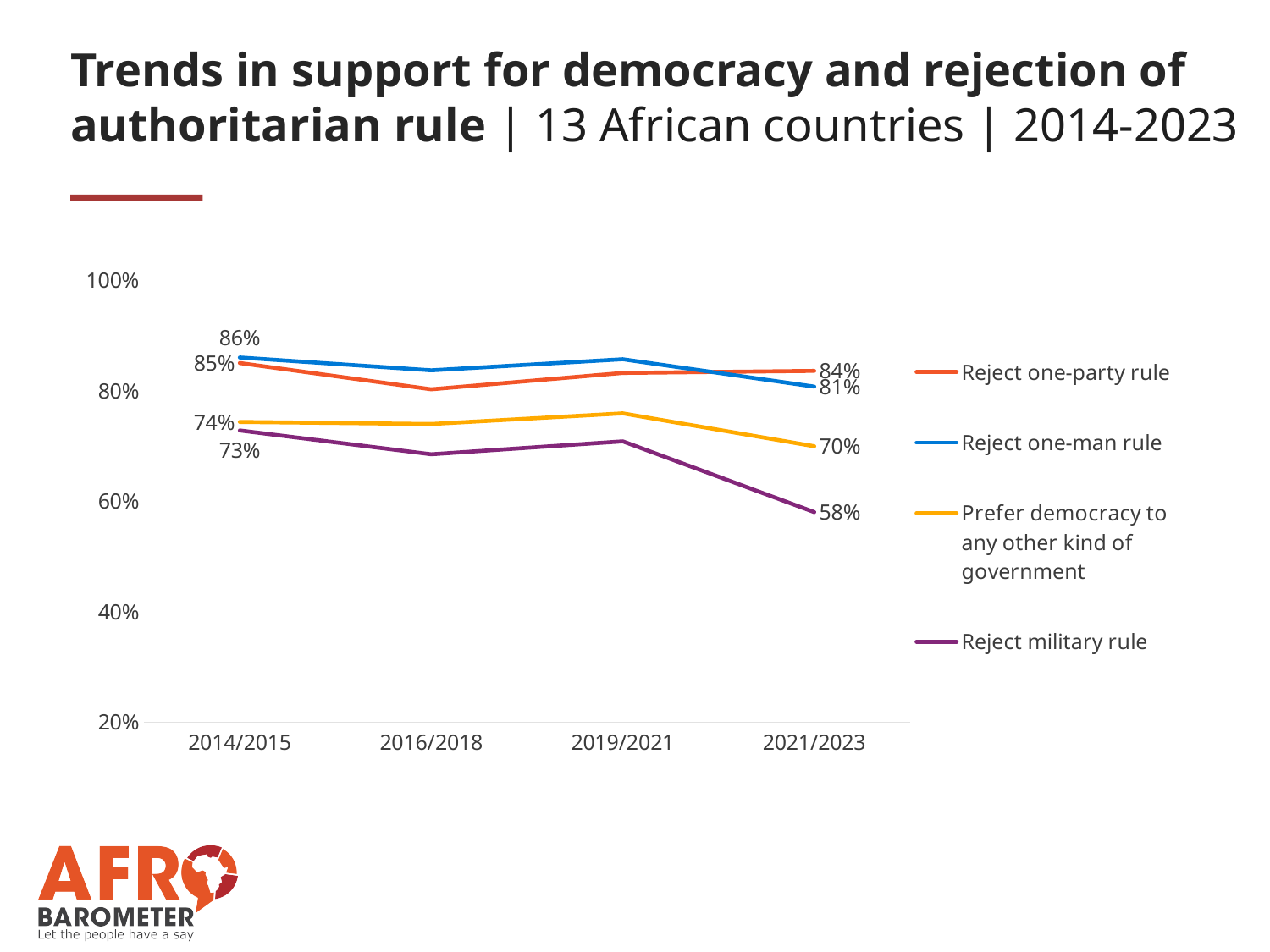
How many series does the legend list? 4 What is the value for Reject one-party rule in 2021/2023? 84% What is the value for Reject military rule in 2021/2023? 58% In 2021/2023, which is higher: Reject one-party rule or Reject one-man rule? Reject one-party rule What is the value for Prefer democracy to any other kind of government in 2014/2015? 74% What is the difference between Reject one-party rule and Reject one-man rule in 2021/2023? 3 percentage points What is the value for Reject one-man rule in 2014/2015? 86% By how many percentage points did Reject military rule change from 2014/2015 to 2021/2023? 15 percentage points Which series has the lowest value in 2021/2023? Reject military rule How many survey periods are shown on the x axis? 4 Is the value for Reject one-man rule in 2016/2018 greater or less than 80%? greater What kind of chart is shown on the slide? Line chart